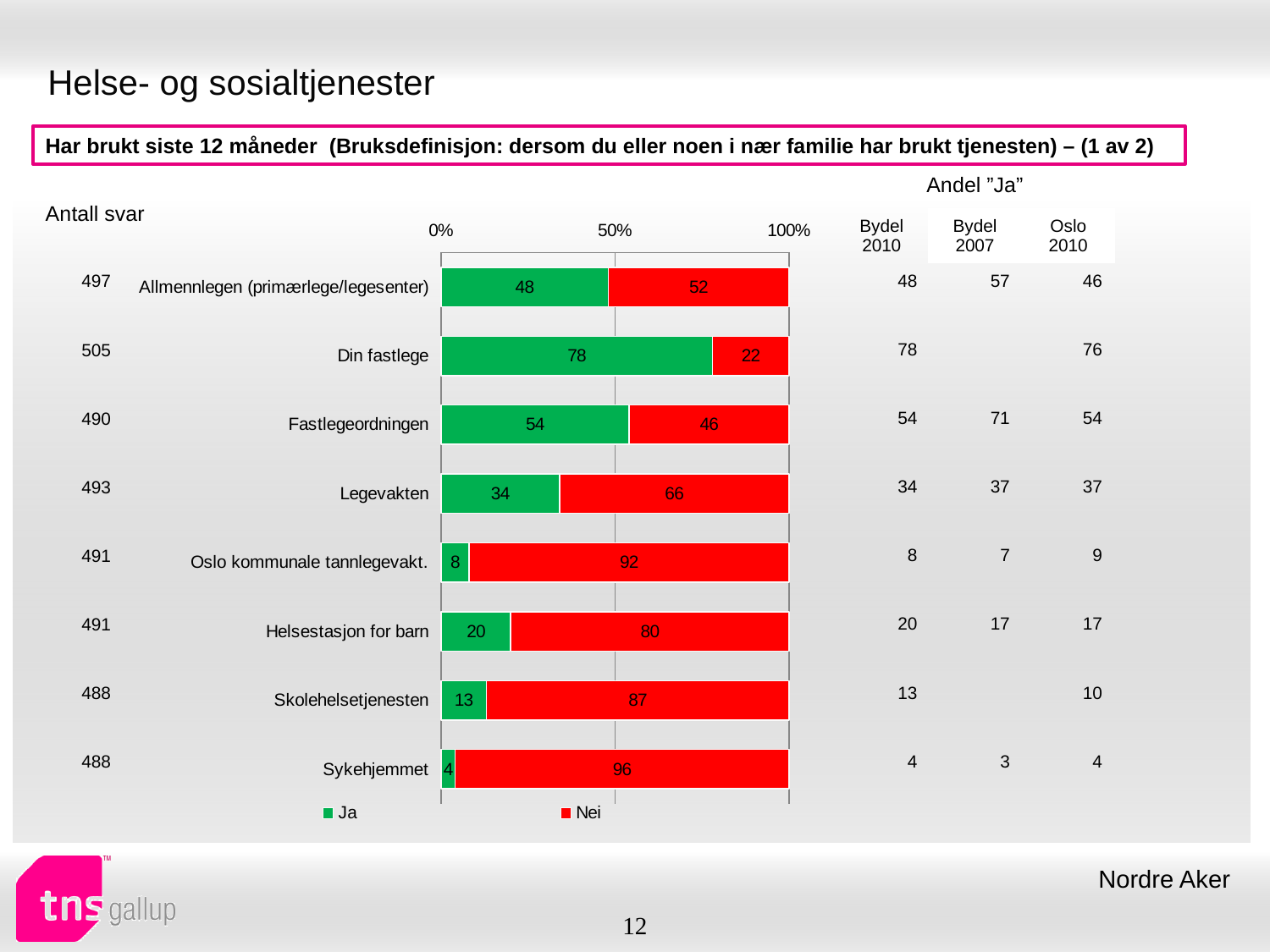
Which category has the lowest "Ja" value? Sykehjemmet Which colour represents the "Nei" series in the chart? Red What is the "Nei" value for Legevakten? 66 Which has a larger "Ja" value, Fastlegeordningen or Legevakten? Fastlegeordningen How many categories are shown in the chart? 8 What is the difference between the "Nei" value for Sykehjemmet and the "Nei" value for Skolehelsetjenesten? 9 What is the total of the stacked bar for Allmennlegen (primærlege/legesenter)? 100 What is the "Ja" value for Helsestasjon for barn? 20 Which category has the highest "Ja" value? Din fastlege What is the "Ja" value for Din fastlege? 78 What kind of chart is shown on the slide? Stacked bar chart How many series does the legend list? 2